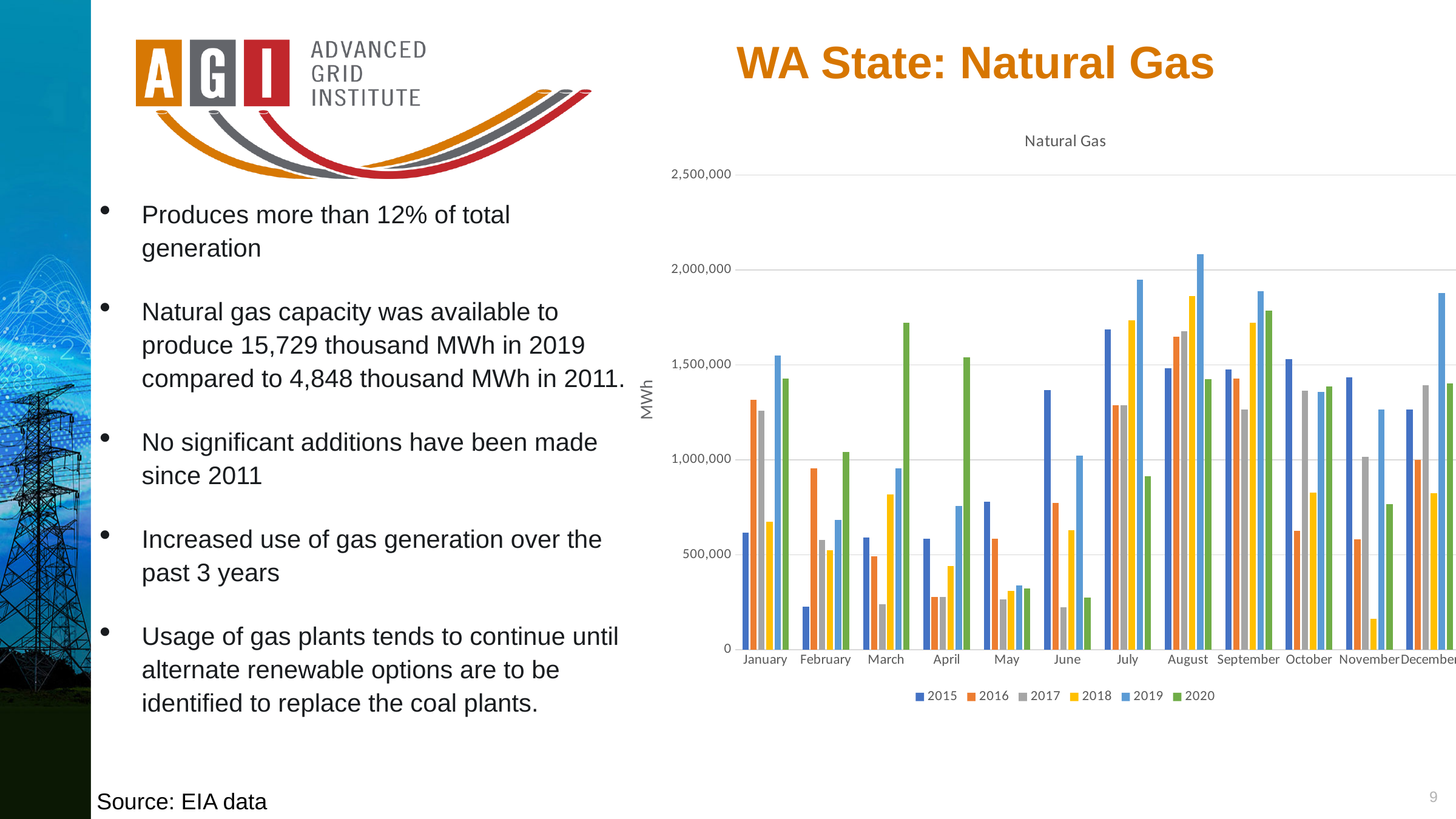
Which year has the lowest bar in November? 2018 How many months are shown on the x axis of the Natural Gas chart? 12 Which years are listed in the legend of the Natural Gas chart? 2015, 2016, 2017, 2018, 2019, 2020 Which year has the highest bar in August? 2019 Is the value for 2019 in August greater or less than 2,000,000? greater Is the value for 2019 in July greater or less than 2,000,000? less In April, which is larger: the value for 2020 or the value for 2015? 2020 Is the value for 2020 in March greater or less than 1,500,000? greater What kind of chart is shown on the slide? Bar chart What is the label on the y axis of the Natural Gas chart? MWh How many series does the legend of the Natural Gas chart list? 6